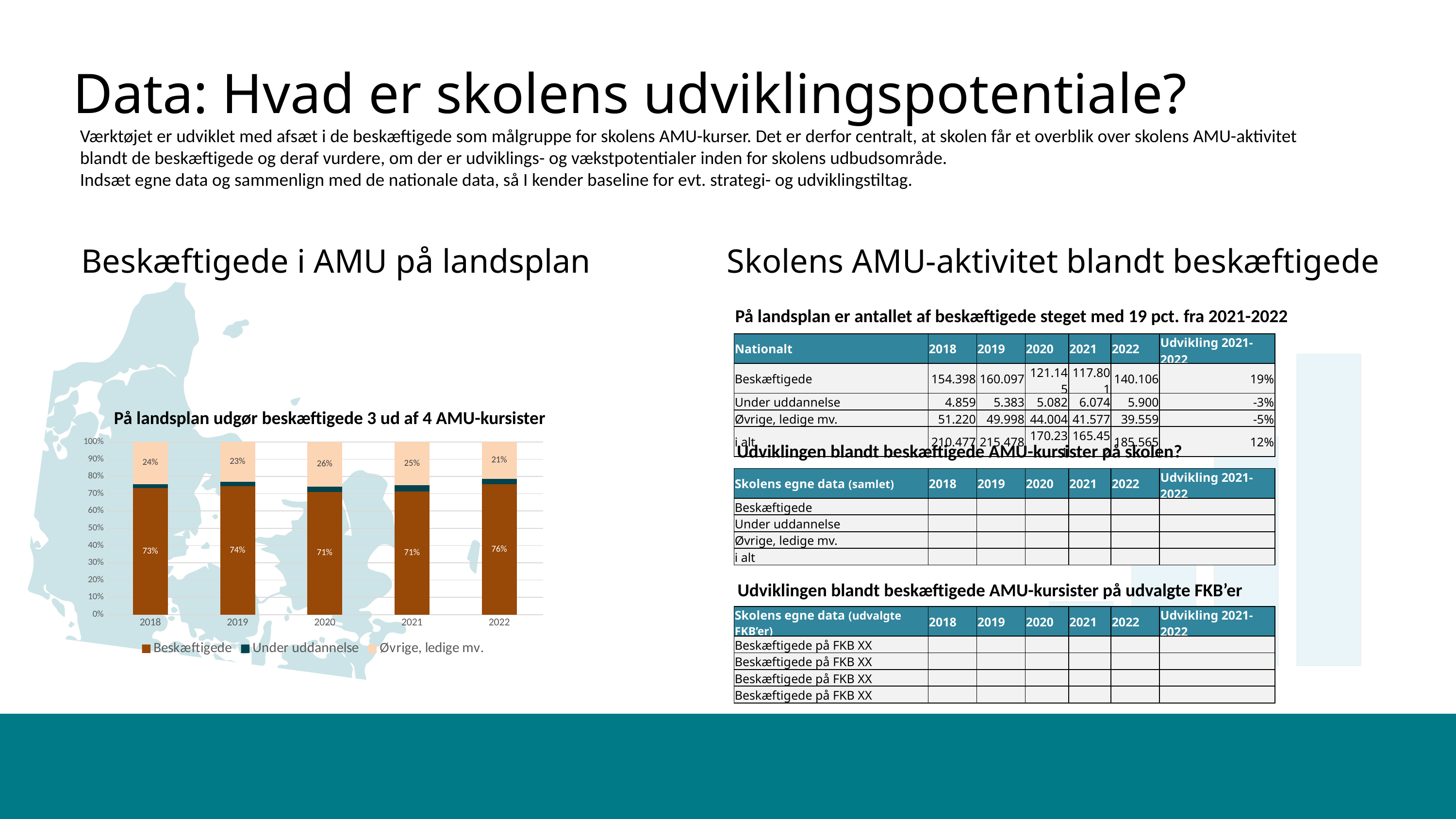
Which is larger: the Beskæftigede share in 2019 or in 2021? 2019 How many series does the chart's legend list? 3 What is the difference between the Beskæftigede share in 2022 and in 2020? 5% What is the value for Beskæftigede in 2018? 73% In which year is the Øvrige, ledige mv. share lowest? 2022 Is the value for Under uddannelse in 2018 greater or less than 10%? less What is the value for Beskæftigede in 2022? 76% What is the value for Øvrige, ledige mv. in 2020? 26% What kind of chart is shown on the slide? Stacked bar chart In which year is the Beskæftigede share highest? 2022 In which year is the Øvrige, ledige mv. share highest? 2020 How many years are shown on the x axis of the chart? 5